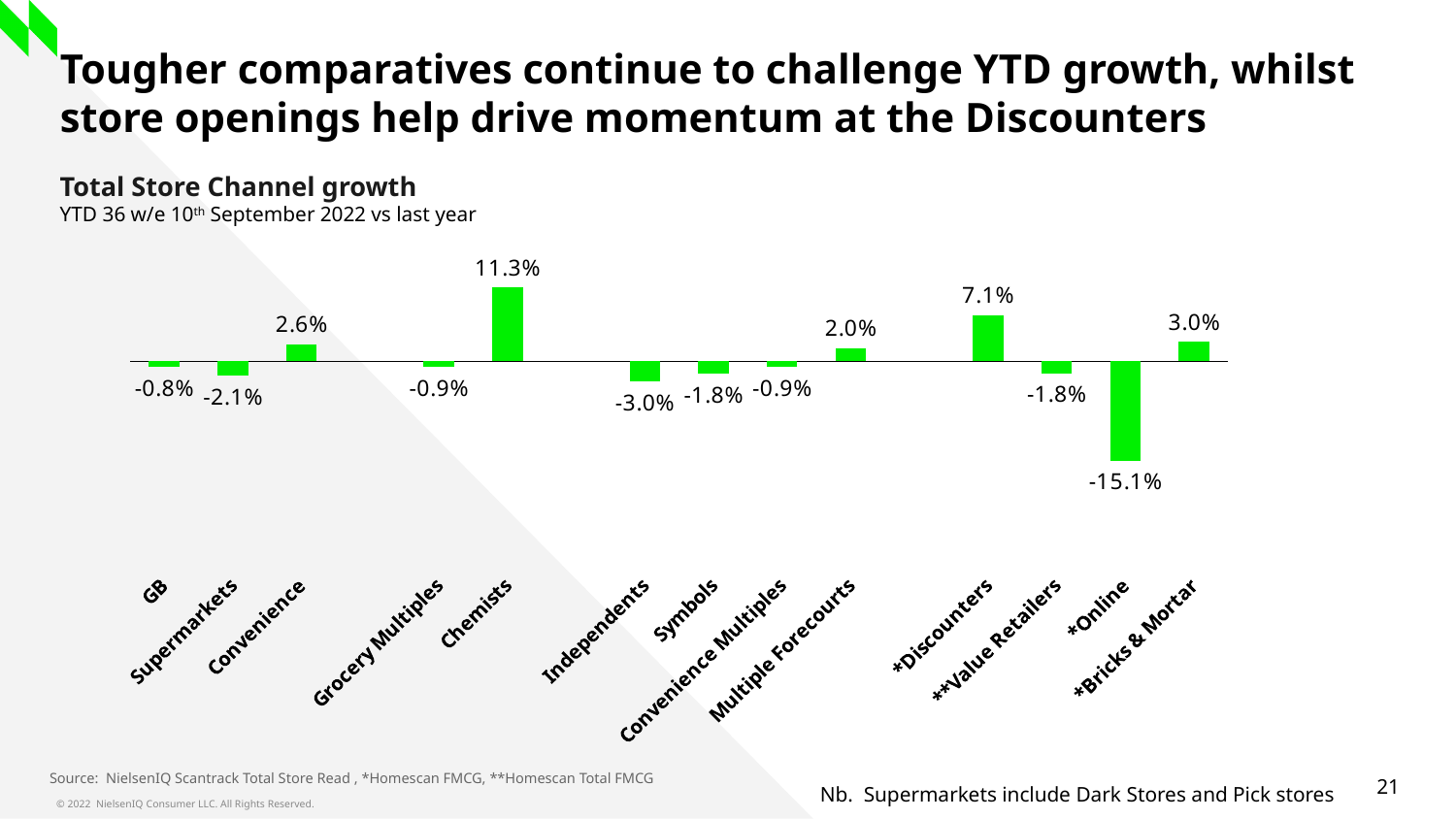
What is the growth value shown for *Online? -15.1% Which has the larger growth value, Convenience or Multiple Forecourts? Convenience How many channel categories are plotted on the chart? 13 What is the growth value shown for Supermarkets? -2.1% What is the growth value shown for Chemists? 11.3% What is the title of the chart? Total Store Channel growth Which channel has the highest growth value? Chemists Which channel has the lowest growth value? *Online What type of chart is used on this slide? Bar chart What is the growth value shown for *Discounters? 7.1% What is the growth value shown for Independents? -3.0% What is the difference in percentage points between the Chemists value and the *Discounters value? 4.2 percentage points